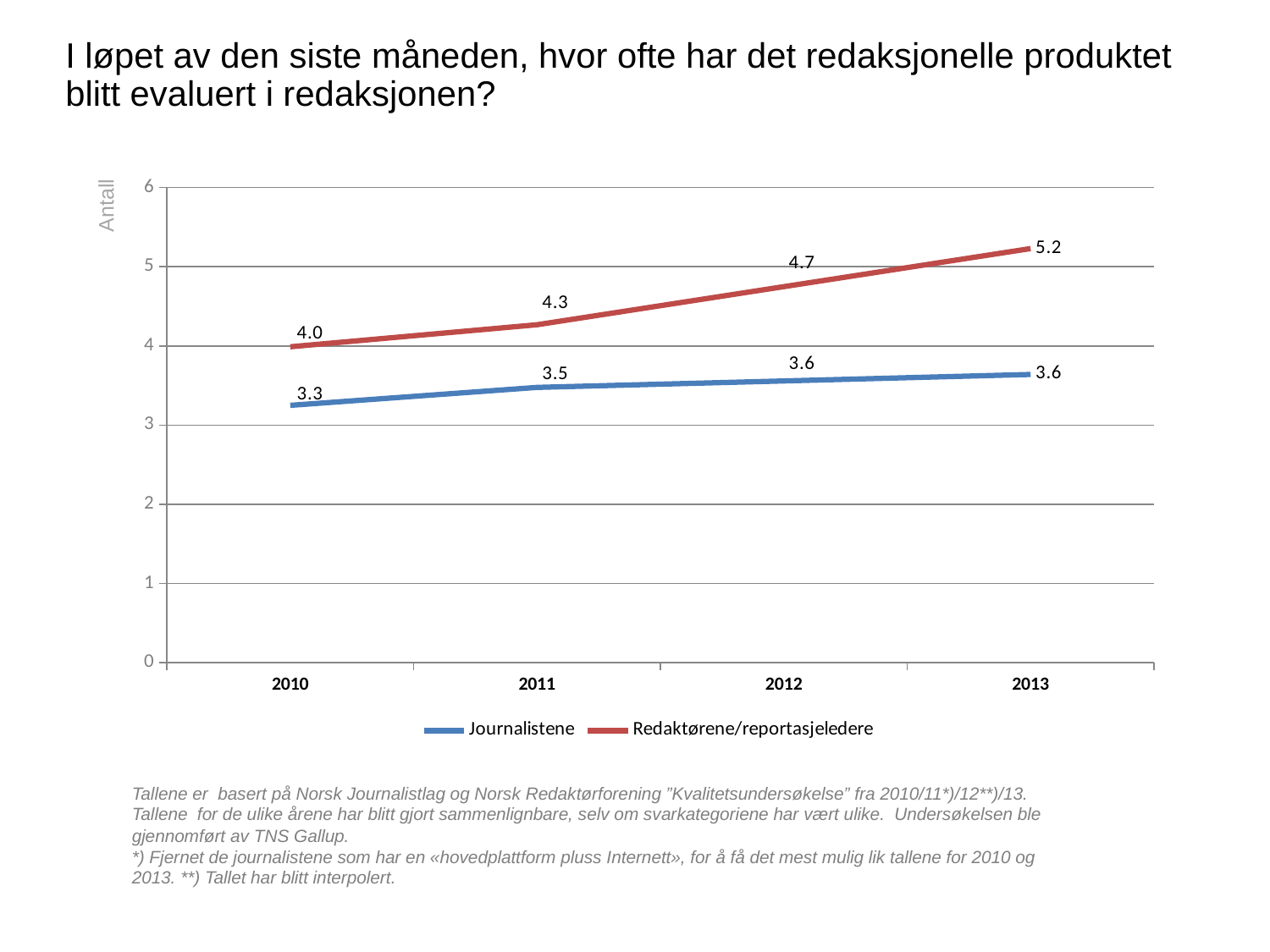
In which year is the Journalistene series lowest? 2010 What kind of chart is shown on the slide? line chart What value does the Journalistene series have in 2012? 3.6 How many series does the legend list? 2 Is the Redaktørene/reportasjeledere value in 2013 greater or less than 5? greater What value does the Journalistene series have in 2010? 3.3 In which year is the Redaktørene/reportasjeledere series highest? 2013 What value does the Redaktørene/reportasjeledere series have in 2013? 5.2 Which series has the larger value in 2012, Journalistene or Redaktørene/reportasjeledere? Redaktørene/reportasjeledere What is the difference between the Redaktørene/reportasjeledere value and the Journalistene value in 2013? 1.6 How many years are shown on the x axis? 4 What value does the Redaktørene/reportasjeledere series have in 2011? 4.3